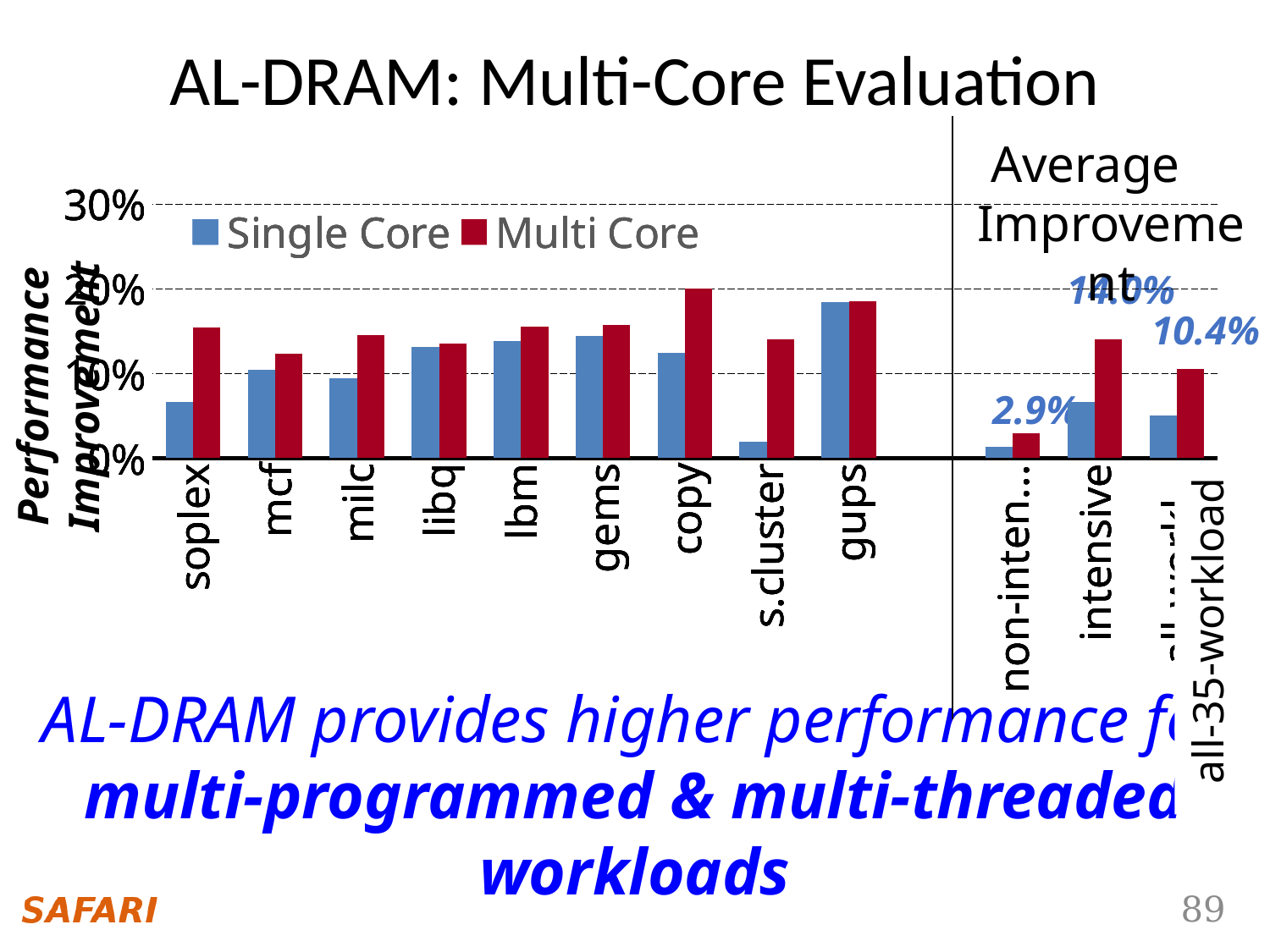
Which benchmark has the highest Multi Core performance improvement? copy What average improvement value is labelled for the intensive workloads? 14.0% How many series does the legend list? 2 What is the title of the chart? AL-DRAM: Multi-Core Evaluation Which benchmark has the highest Single Core performance improvement? gups Is the Single Core value for s.cluster greater or less than 10%? less How many benchmarks are plotted to the left of the vertical divider line? 9 For milc, which is larger: the Single Core or the Multi Core value? Multi Core What are the two series named in the legend? Single Core and Multi Core Among the nine benchmarks left of the divider, which has the lowest Single Core performance improvement? s.cluster What kind of chart is shown on the slide? bar chart Is the Multi Core value for copy greater or less than 10%? greater